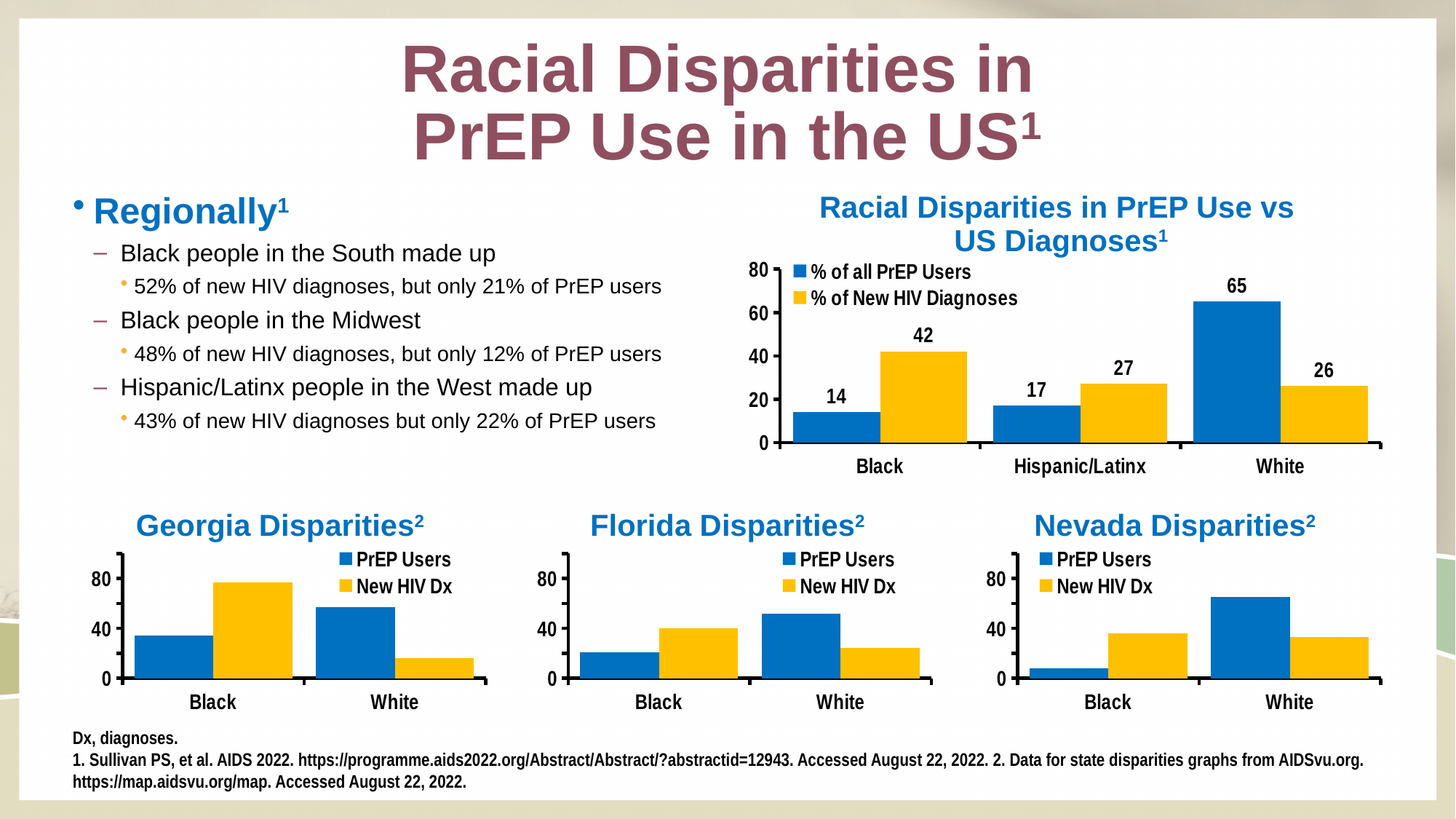
In the 'Florida Disparities' chart, is the PrEP Users value for White greater or less than 40? greater What kind of chart is the 'Georgia Disparities' chart? Bar chart In the 'Nevada Disparities' chart, which group has the larger PrEP Users value, Black or White? White In the 'Racial Disparities in PrEP Use vs US Diagnoses' chart, what is the % of all PrEP Users for White? 65 How many series does the legend of the 'Racial Disparities in PrEP Use vs US Diagnoses' chart list? 2 In the 'Racial Disparities in PrEP Use vs US Diagnoses' chart, what is the difference between the % of New HIV Diagnoses and the % of all PrEP Users for Black? 28 In the 'Racial Disparities in PrEP Use vs US Diagnoses' chart, what is the % of New HIV Diagnoses for Black? 42 In the 'Racial Disparities in PrEP Use vs US Diagnoses' chart, which group has the highest % of all PrEP Users? White How many racial/ethnic groups are shown on the x axis of the 'Racial Disparities in PrEP Use vs US Diagnoses' chart? 3 In the 'Georgia Disparities' chart, is the New HIV Dx value for Black greater or less than 40? greater In the 'Nevada Disparities' chart, is the PrEP Users value for Black greater or less than 40? less In the 'Racial Disparities in PrEP Use vs US Diagnoses' chart, for Hispanic/Latinx, which is larger: % of all PrEP Users or % of New HIV Diagnoses? % of New HIV Diagnoses